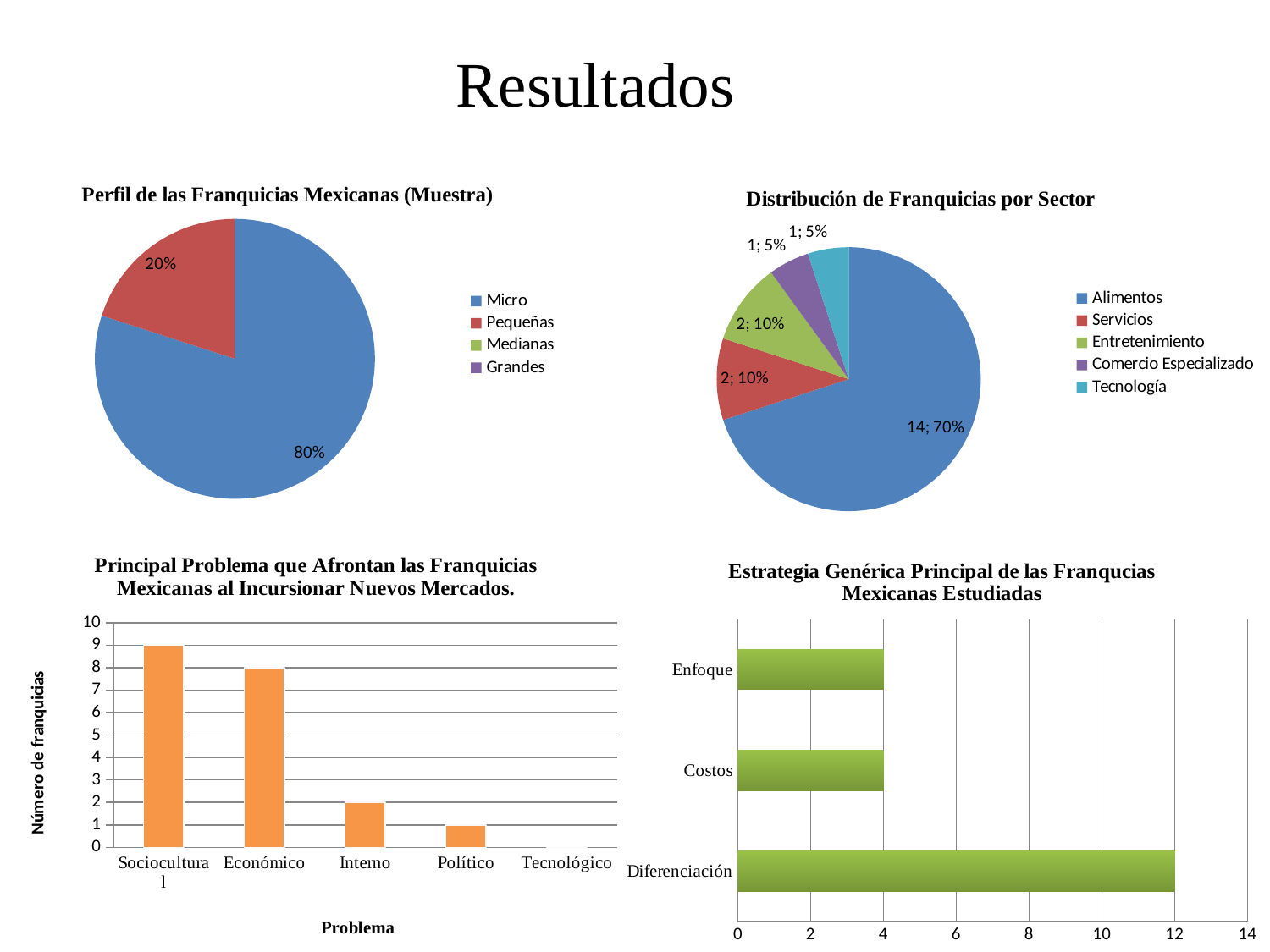
In the 'Distribución de Franquicias por Sector' pie chart, which sector has the largest slice? Alimentos In the 'Principal Problema que Afrontan las Franquicias Mexicanas al Incursionar Nuevos Mercados' chart, which problem has the highest value? Sociocultural How many categories are shown on the x axis of the 'Principal Problema que Afrontan las Franquicias Mexicanas al Incursionar Nuevos Mercados' chart? 5 How many entries does the legend of the 'Distribución de Franquicias por Sector' pie chart list? 5 In the 'Principal Problema que Afrontan las Franquicias Mexicanas al Incursionar Nuevos Mercados' chart, what is the difference between Sociocultural and Económico? 1 In the 'Estrategia Genérica Principal de las Franqucias Mexicanas Estudiadas' chart, what is the difference between Diferenciación and Costos? 8 In the 'Perfil de las Franquicias Mexicanas (Muestra)' pie chart, what share does Micro have? 80% In the 'Principal Problema que Afrontan las Franquicias Mexicanas al Incursionar Nuevos Mercados' chart, what is the value for Sociocultural? 9 What kind of chart is 'Estrategia Genérica Principal de las Franqucias Mexicanas Estudiadas'? Bar chart In the 'Estrategia Genérica Principal de las Franqucias Mexicanas Estudiadas' chart, what is the value for Diferenciación? 12 In the 'Distribución de Franquicias por Sector' pie chart, what percentage does Alimentos have? 70% In the 'Perfil de las Franquicias Mexicanas (Muestra)' pie chart, what share does Pequeñas have? 20%